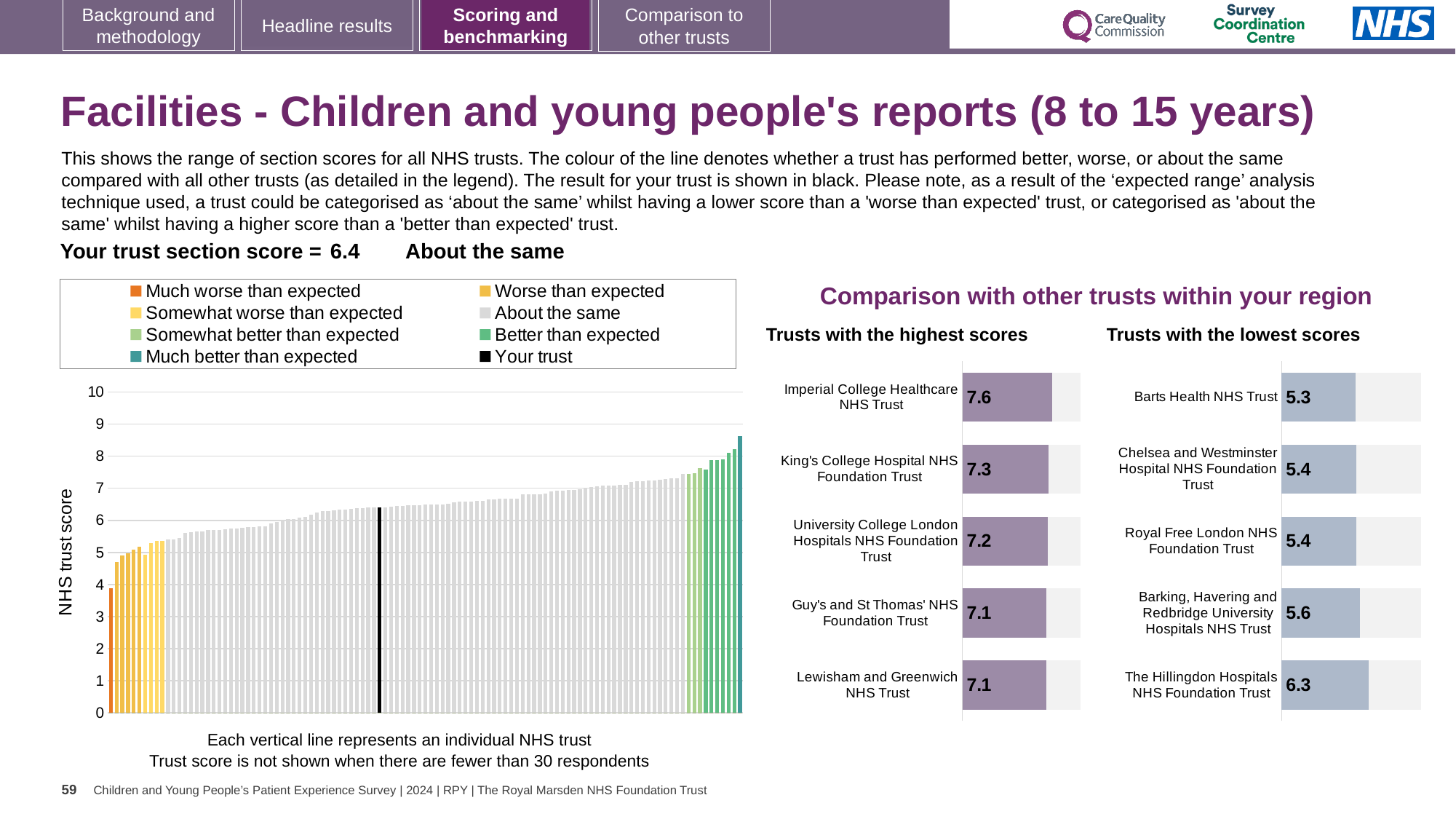
In the 'Trusts with the lowest scores' chart, which has the larger score: Barts Health NHS Trust or Barking, Havering and Redbridge University Hospitals NHS Trust? Barking, Havering and Redbridge University Hospitals NHS Trust In the 'Trusts with the highest scores' chart, what is the difference between the scores of Imperial College Healthcare NHS Trust and King's College Hospital NHS Foundation Trust? 0.3 In the main NHS trust score chart on the left, is the value for your trust (the black bar) greater or less than 5? greater What kind of chart is the main NHS trust score chart on the left? Bar chart In the 'Trusts with the lowest scores' chart, what is the score for The Hillingdon Hospitals NHS Foundation Trust? 6.3 In the main NHS trust score chart on the left, what is the section score for your trust (the black bar)? 6.4 In the main NHS trust score chart on the left, do the trust scores rise or fall from left to right? Rise How many trusts are listed in the 'Trusts with the highest scores' chart? 5 In the 'Trusts with the highest scores' chart, which trust has the highest score? Imperial College Healthcare NHS Trust How many entries does the legend of the main NHS trust score chart list? 8 In the 'Trusts with the lowest scores' chart, which trust has the lowest score? Barts Health NHS Trust In the 'Trusts with the highest scores' chart, what is the score for Imperial College Healthcare NHS Trust? 7.6